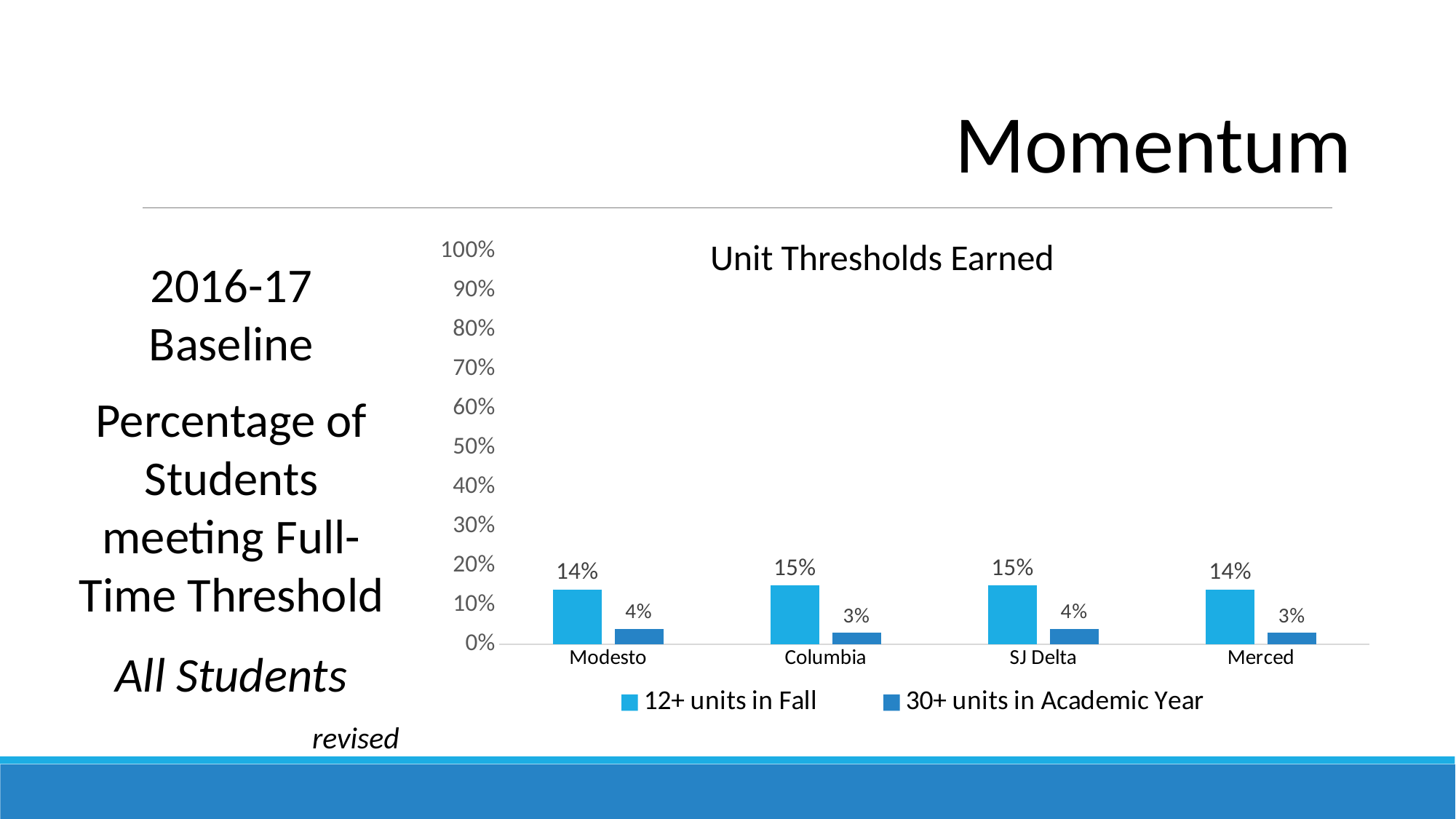
What is the difference between the 12+ units in Fall value and the 30+ units in Academic Year value at Columbia? 12% Is the value for 12+ units in Fall at Merced greater or less than 20%? less How many colleges are shown on the x axis? 4 What is the title of the chart? Unit Thresholds Earned How many series does the legend list? 2 What is the value for 30+ units in Academic Year at Merced? 3% What is the value for 30+ units in Academic Year at Columbia? 3% Which is larger at SJ Delta: 12+ units in Fall or 30+ units in Academic Year? 12+ units in Fall What is the value for 12+ units in Fall at Modesto? 14% What kind of chart is shown? bar chart What is the difference between the 12+ units in Fall value and the 30+ units in Academic Year value at Modesto? 10% What is the value for 12+ units in Fall at SJ Delta? 15%